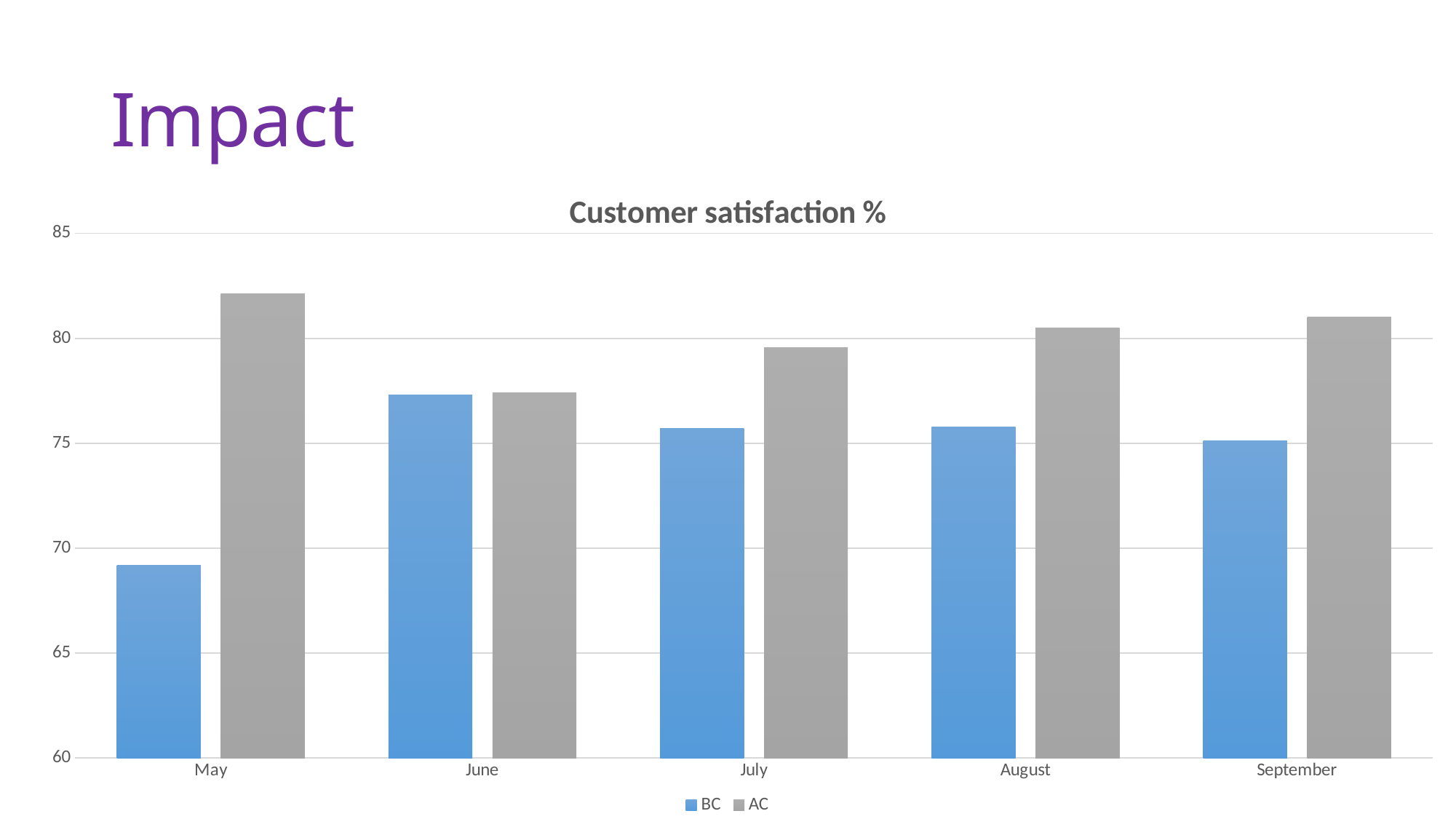
How many months are shown on the x axis? 5 In May, which is larger, the BC value or the AC value? AC What is the title of the chart? Customer satisfaction % Is the AC value for July greater or less than 80? less Which month has the lowest AC value? June How many series does the legend list? 2 Which month has the highest AC value? May Which month has the highest BC value? June Is the BC value for May greater or less than 70? less What kind of chart is shown on the slide? bar chart Which month has the lowest BC value? May Which colour represents the AC series in the legend? grey